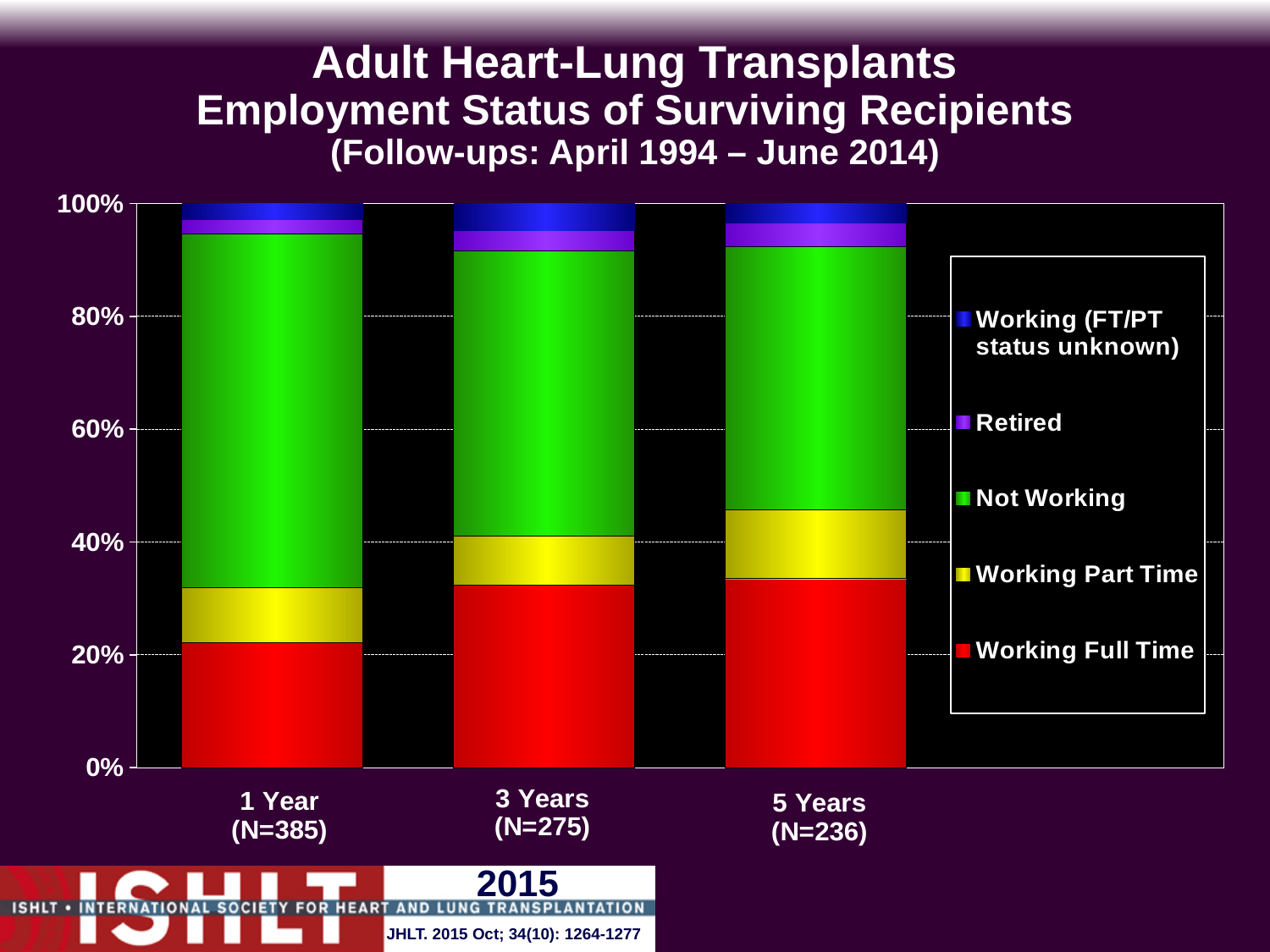
What kind of chart is shown on the slide? Stacked bar chart Is the Not Working share at 1 Year greater or less than 40%? greater Which legend entry is shown in red? Working Full Time How many follow-up time categories are shown on the x axis? 3 Is the Working Full Time share larger at 1 Year or at 5 Years? 5 Years What is the N for the 3 Years follow-up group? N=275 Is the Working Full Time value at 1 Year greater or less than 40%? less Does the Working Full Time share rise or fall from 1 Year to 5 Years? rise Is the Working Full Time value at 3 Years greater or less than 40%? less Is the Not Working share larger at 1 Year or at 5 Years? 1 Year How many series does the legend list? 5